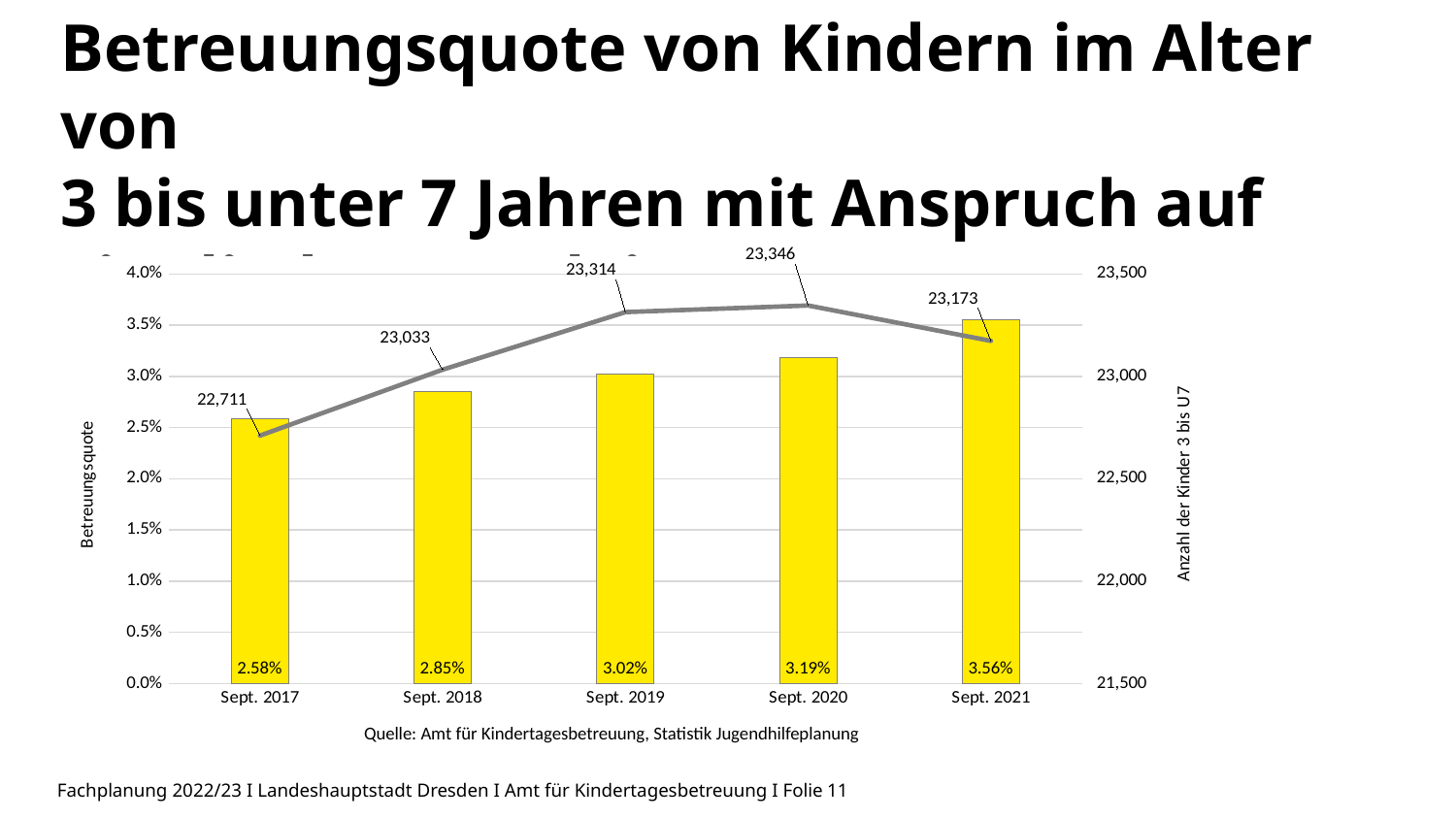
In which period is the Anzahl der Kinder 3 bis U7 highest? Sept. 2020 What is the Anzahl der Kinder 3 bis U7 for Sept. 2018? 23,033 In which period is the Betreuungsquote highest? Sept. 2021 Which is larger, the Anzahl der Kinder 3 bis U7 in Sept. 2019 or in Sept. 2021? Sept. 2019 What is the difference in Anzahl der Kinder 3 bis U7 between Sept. 2020 and Sept. 2021? 173 What is the Betreuungsquote for Sept. 2017? 2.58% What is the Betreuungsquote for Sept. 2021? 3.56% How many time periods are shown on the x axis? 5 What is the difference in Betreuungsquote between Sept. 2021 and Sept. 2020? 0.37% Does the Betreuungsquote rise or fall from Sept. 2017 to Sept. 2021? rise In which period is the Anzahl der Kinder 3 bis U7 lowest? Sept. 2017 What is the Anzahl der Kinder 3 bis U7 for Sept. 2019? 23,314